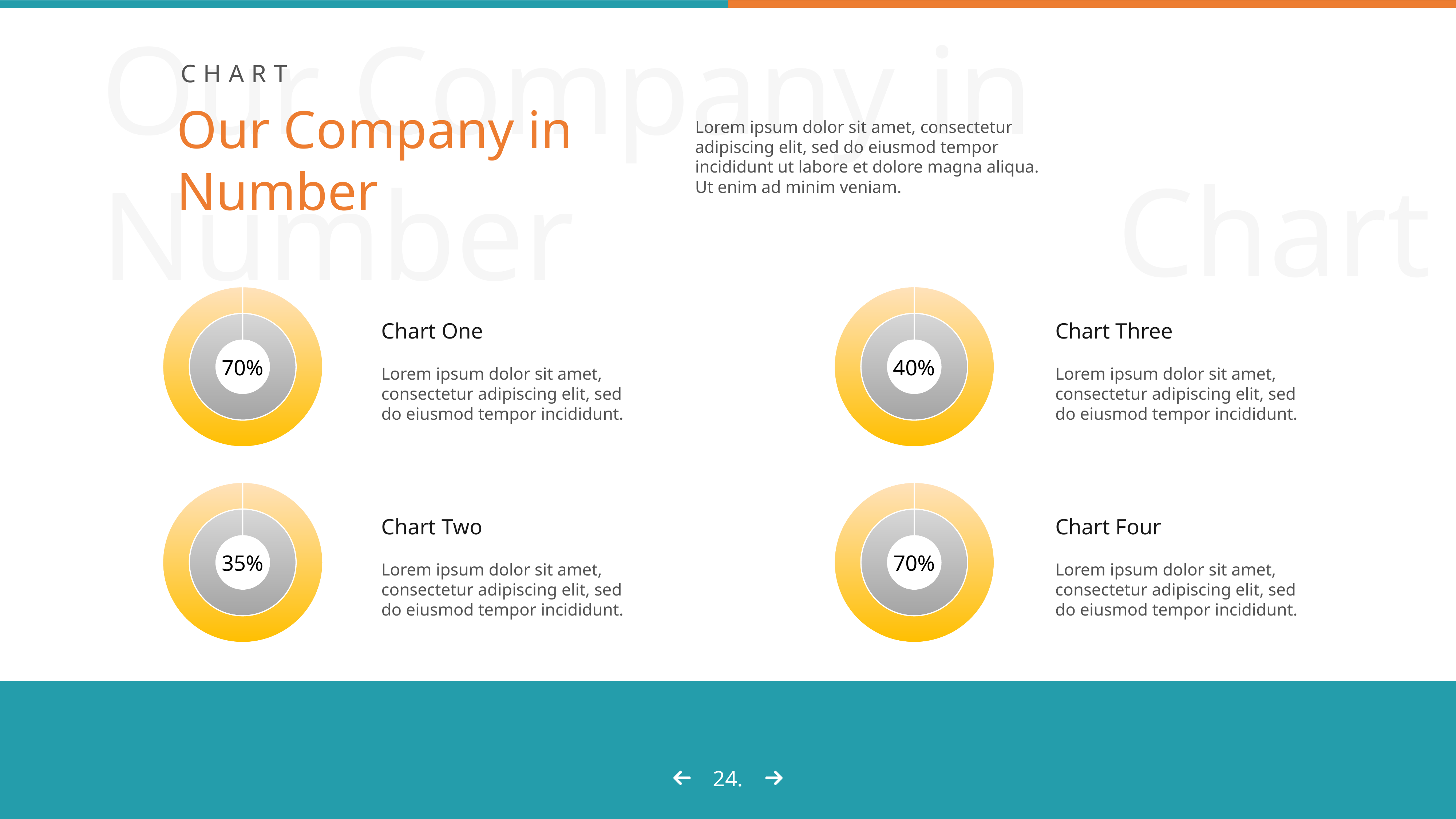
Which shows a larger percentage, Chart One or Chart Two? Chart One What value is shown in the centre of the Chart Three doughnut? 40% Which of the four charts shows the lowest percentage? Chart Two What is the difference in percentage points between Chart Four and Chart Three? 30 Which shows a larger percentage, Chart Three or Chart Two? Chart Three How many doughnut charts are shown on the slide? 4 What is the difference in percentage points between Chart One and Chart Two? 35 What value is shown in the centre of the Chart Two doughnut? 35% What value is shown in the centre of the Chart Four doughnut? 70% What kind of chart is used for Chart One? Doughnut chart What is the main title of the slide above the charts? Our Company in Number What value is shown in the centre of the Chart One doughnut? 70%